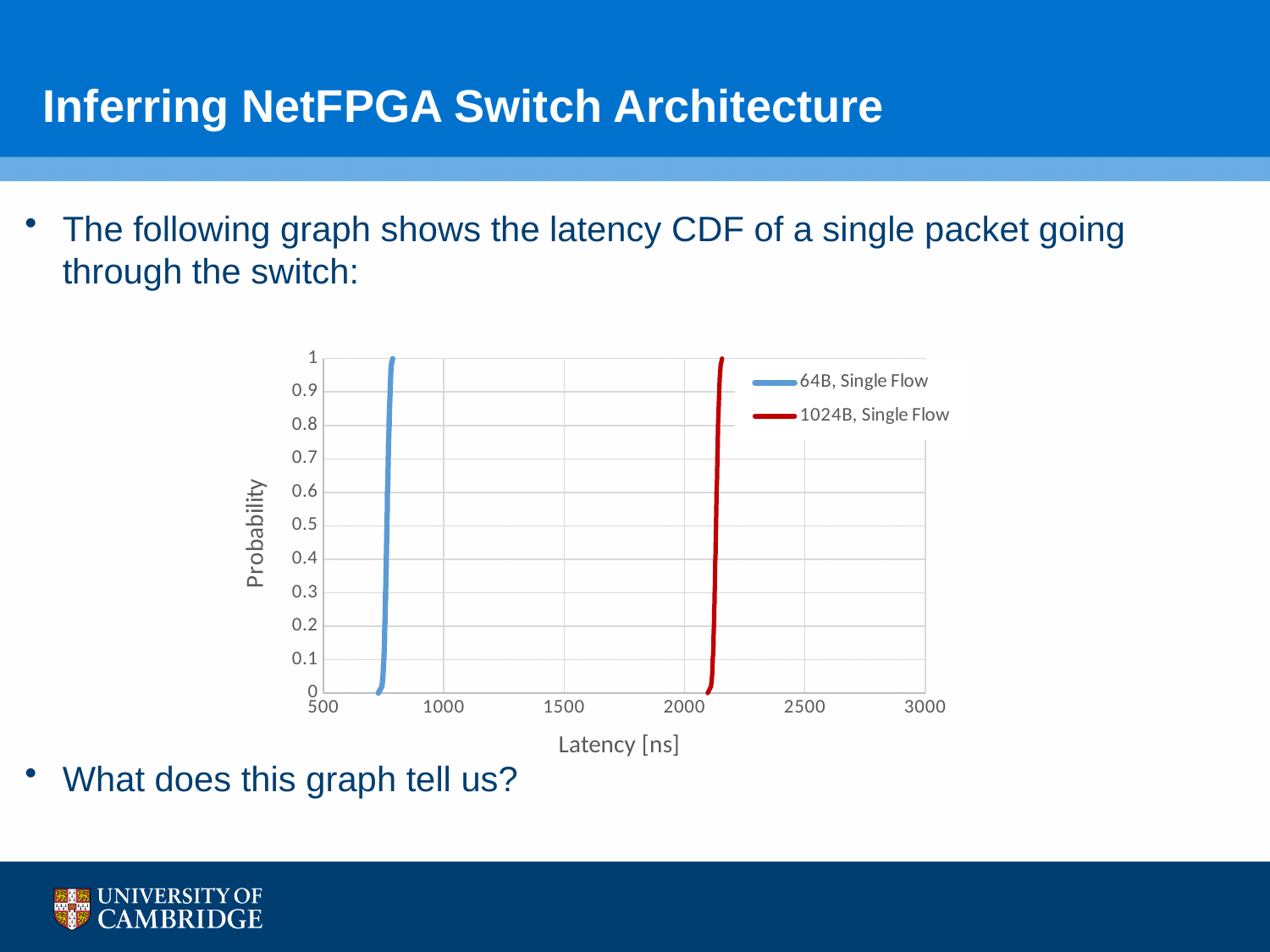
Is the latency of the 1024B, Single Flow series greater or less than 2000 ns? greater Which series has the higher latency, 64B Single Flow or 1024B Single Flow? 1024B, Single Flow Is the latency of the 64B, Single Flow series greater or less than 1000 ns? less What is the label of the x axis? Latency [ns] Is the latency of the 64B, Single Flow series greater or less than 500 ns? greater Which series is drawn in red? 1024B, Single Flow What kind of chart is shown on the slide? Line chart What is the maximum value shown on the x axis? 3000 How many series does the chart legend list? 2 Does the probability rise or fall as latency increases along each curve? rise